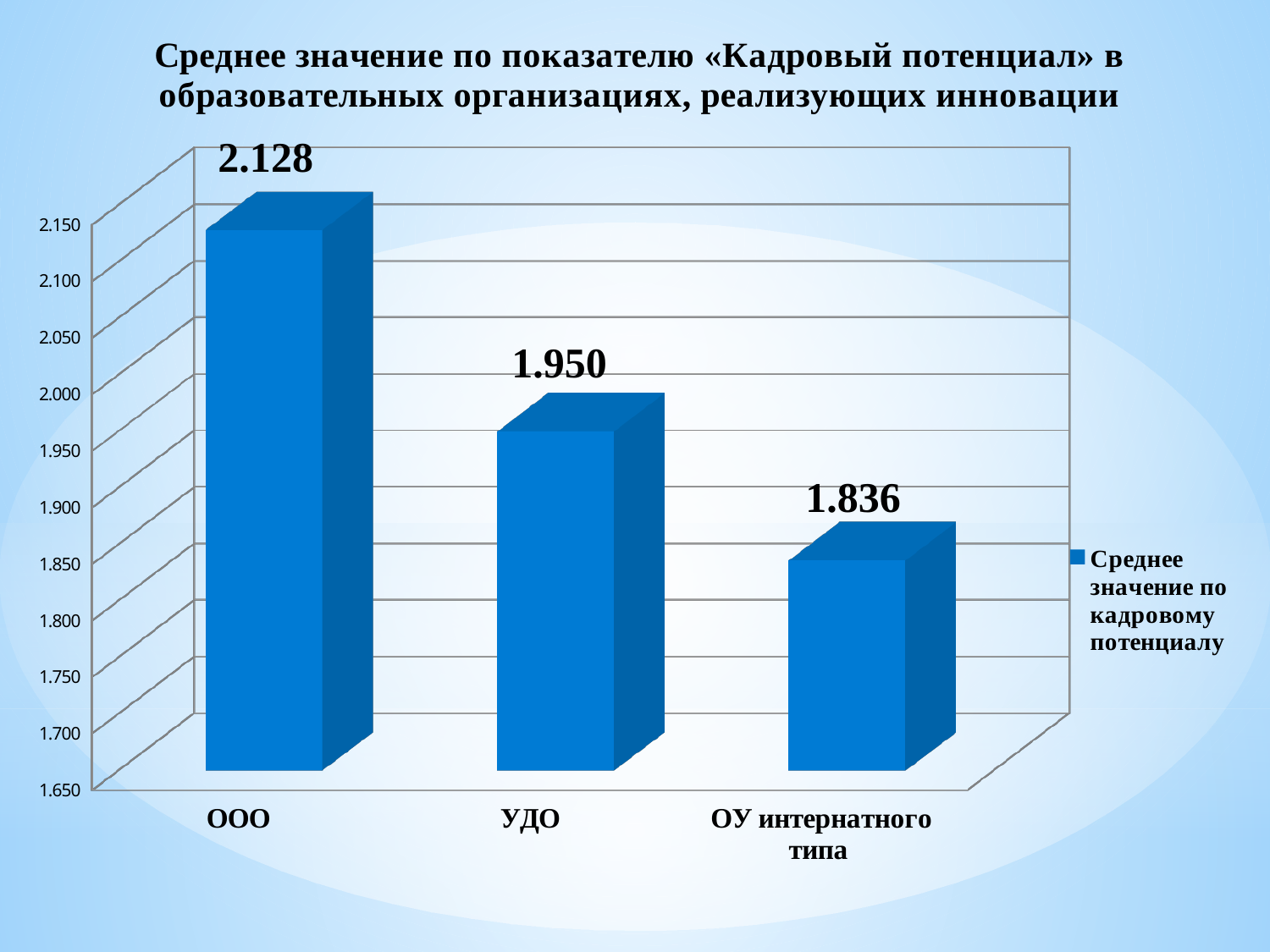
How many categories are shown on the x axis? 3 Do the values rise or fall from left to right along the x axis? fall How many series does the legend list? 1 What kind of chart is shown on the slide? bar chart What is the difference between the values for УДО and ОУ интернатного типа? 0.114 What is the value for УДО? 1.950 Which category has the highest value? ООО Which category has the lowest value? ОУ интернатного типа What is the difference between the values for ООО and УДО? 0.178 Which is larger, the value for УДО or the value for ОУ интернатного типа? УДО What is the value for ООО? 2.128 What is the value for ОУ интернатного типа? 1.836